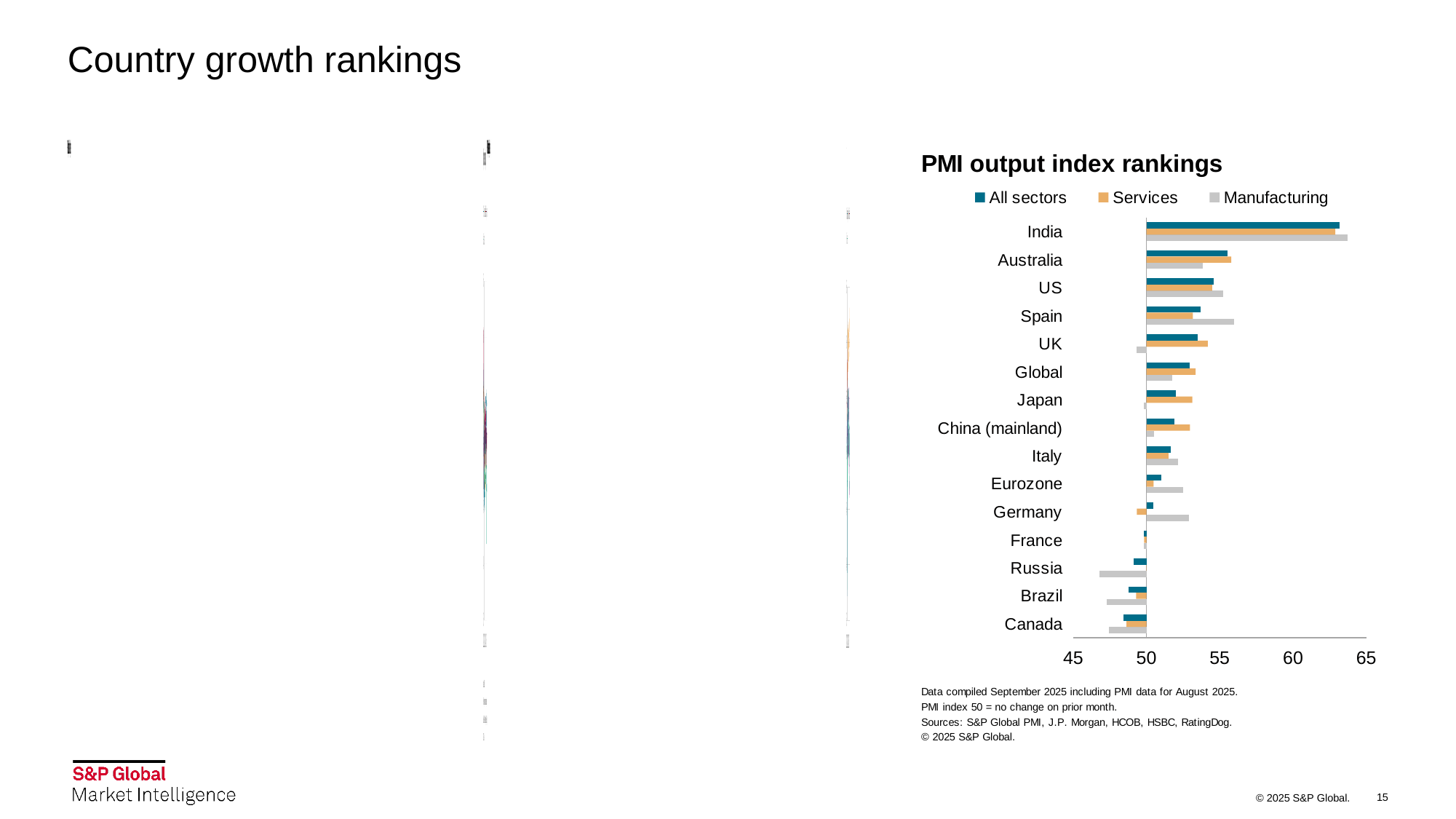
On the 'PMI output index rankings' chart, is the 'All sectors' value for Canada greater or less than 50? less How many countries or regions are shown on the 'PMI output index rankings' chart? 15 On the 'PMI output index rankings' chart, is the 'Manufacturing' value for Spain greater or less than 55? greater Which country has the highest 'All sectors' value on the 'PMI output index rankings' chart? India On the 'PMI output index rankings' chart, is the 'Manufacturing' value for Russia greater or less than 50? less What kind of chart is the 'PMI output index rankings' chart? bar chart How many series does the legend of the 'PMI output index rankings' chart list? 3 Which country has the highest 'Manufacturing' value on the 'PMI output index rankings' chart? India What are the three series listed in the legend of the 'PMI output index rankings' chart? All sectors, Services, Manufacturing Which country has the lowest 'All sectors' value on the 'PMI output index rankings' chart? Canada On the 'PMI output index rankings' chart, which is larger for the UK: the 'Services' value or the 'Manufacturing' value? Services